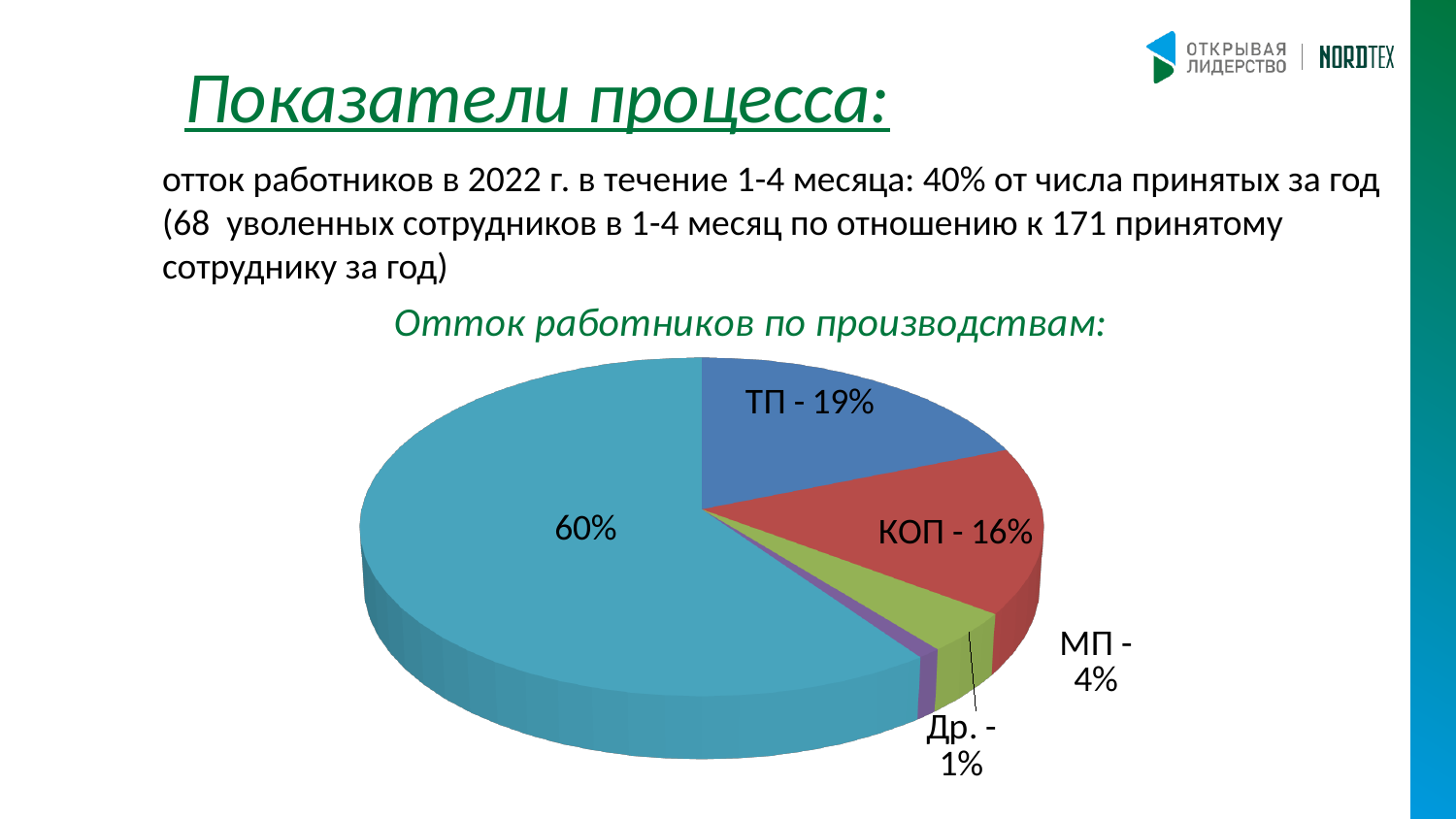
What is the difference in percentage points between the МП slice and the Др. slice? 3% What percentage is shown on the largest slice of the pie? 60% What is the title of the chart? Отток работников по производствам: What share of the pie does Др. account for? 1% What share of the pie does ТП account for? 19% How many slices does the pie chart have? 5 Which is larger, the slice for ТП or the slice for КОП? ТП What share of the pie does КОП account for? 16% Which labelled category has the smallest slice of the pie? Др. What kind of chart is shown on the slide? pie chart What is the difference in percentage points between the ТП slice and the КОП slice? 3% What share of the pie does МП account for? 4%